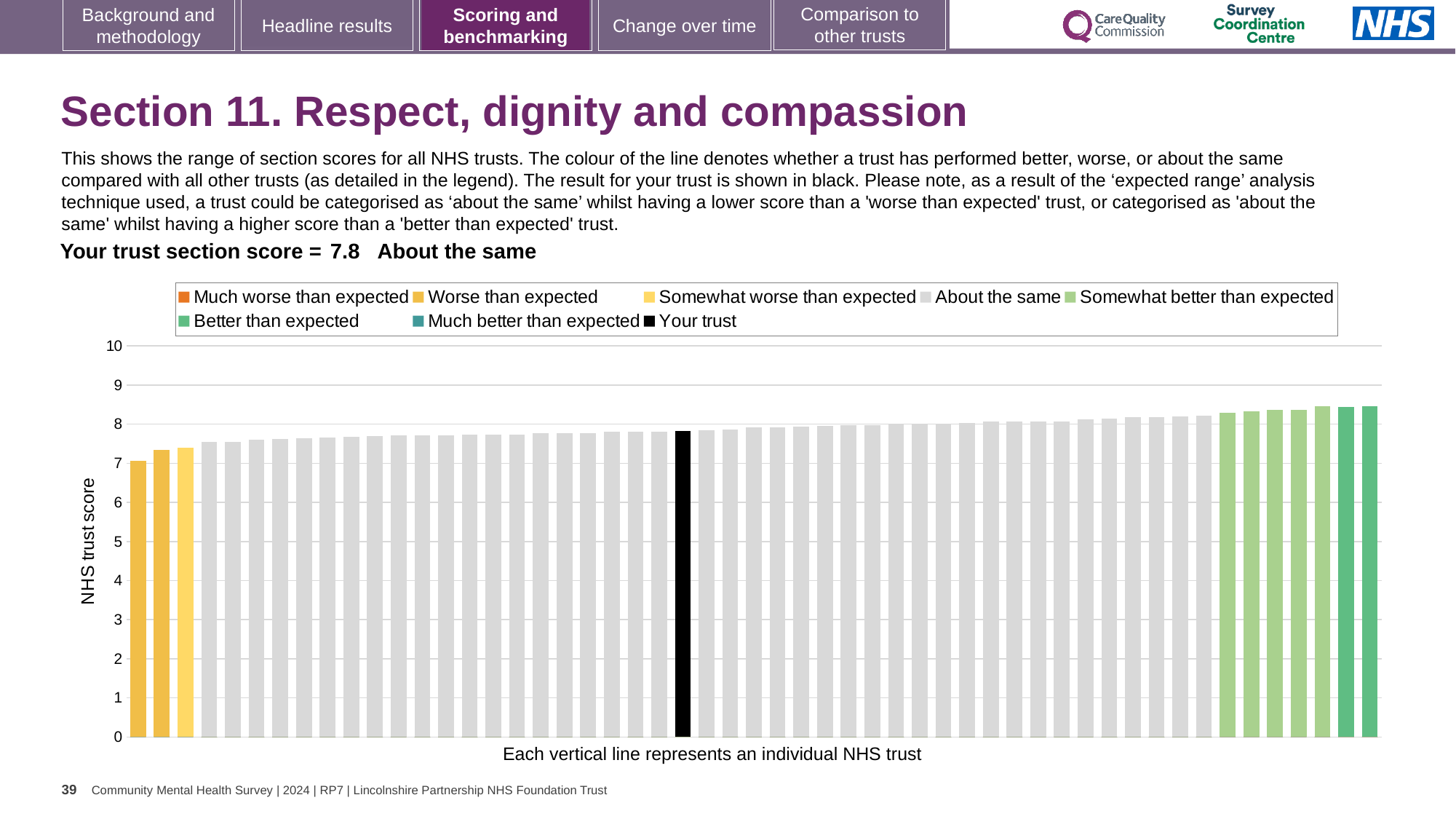
Is the value for the highest bar greater or less than 8? greater Which category is your trust placed in for this section? About the same Is the value for your trust greater or less than 8? less What is the label on the y axis of the chart? NHS trust score What is the section score for your trust shown on the slide? 7.8 Which is larger, the value for your trust or the value for the highest bar? the highest bar Do the bar values rise or fall from left to right along the x axis? rise Is the value for the lowest bar greater or less than 8? less What kind of chart is shown on the slide? bar chart How many entries does the chart legend list? 8